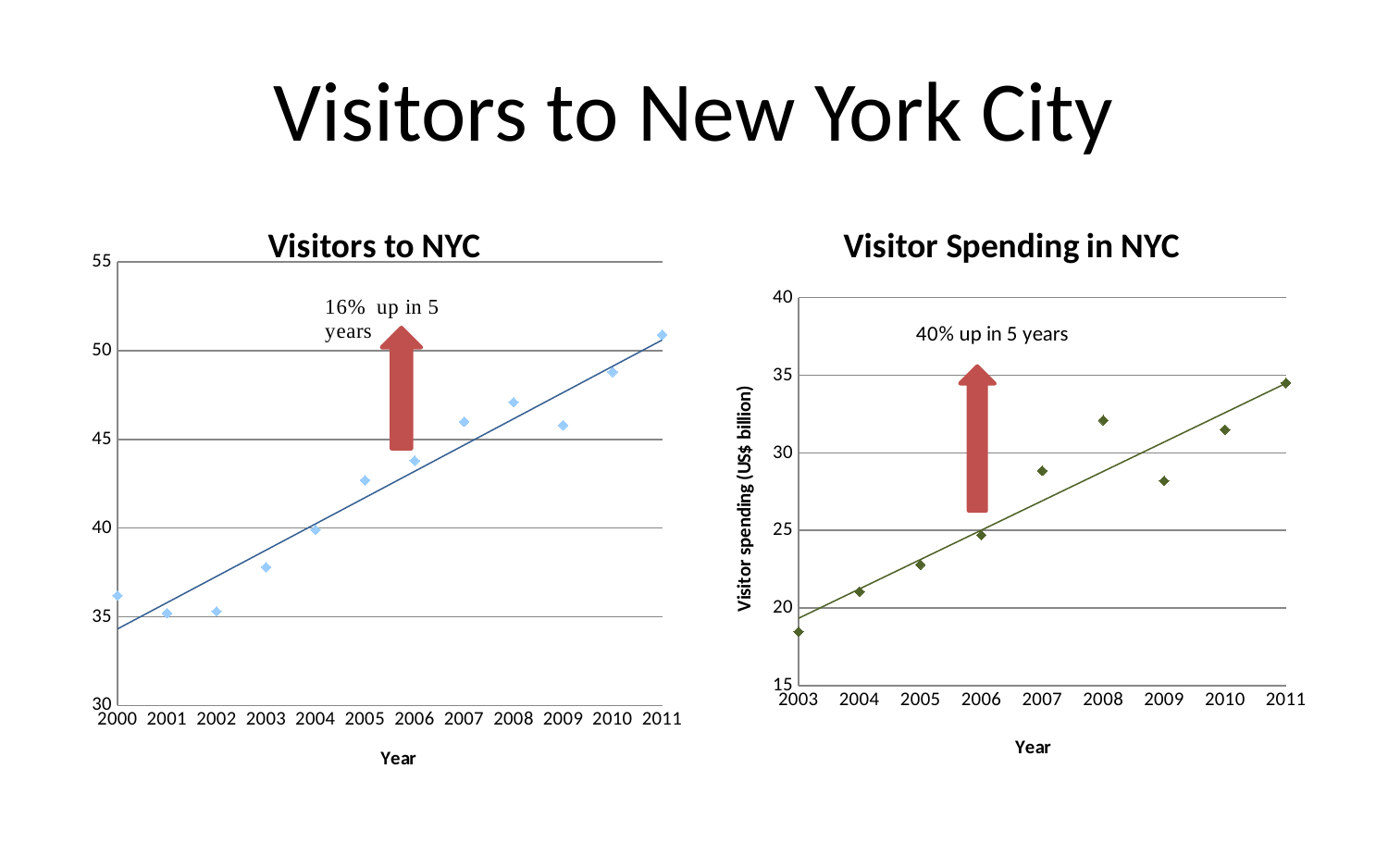
On the 'Visitor Spending in NYC' chart, which year has the highest value? 2011 On the 'Visitor Spending in NYC' chart, is the value for 2008 greater or less than 30? greater On the 'Visitors to NYC' chart, is the value for 2005 greater or less than 40? greater On the 'Visitor Spending in NYC' chart, is the value for 2003 greater or less than 20? less What kind of chart is the 'Visitors to NYC' chart? scatter chart On the 'Visitor Spending in NYC' chart, how many years are plotted? 9 On the 'Visitors to NYC' chart, how many years are plotted? 12 On the 'Visitors to NYC' chart, which year has the highest value? 2011 On the 'Visitor Spending in NYC' chart, which year has the lowest value? 2003 On the 'Visitor Spending in NYC' chart, what is the label on the vertical axis? Visitor spending (US$ billion) On the 'Visitor Spending in NYC' chart, which is larger, the value for 2008 or the value for 2009? 2008